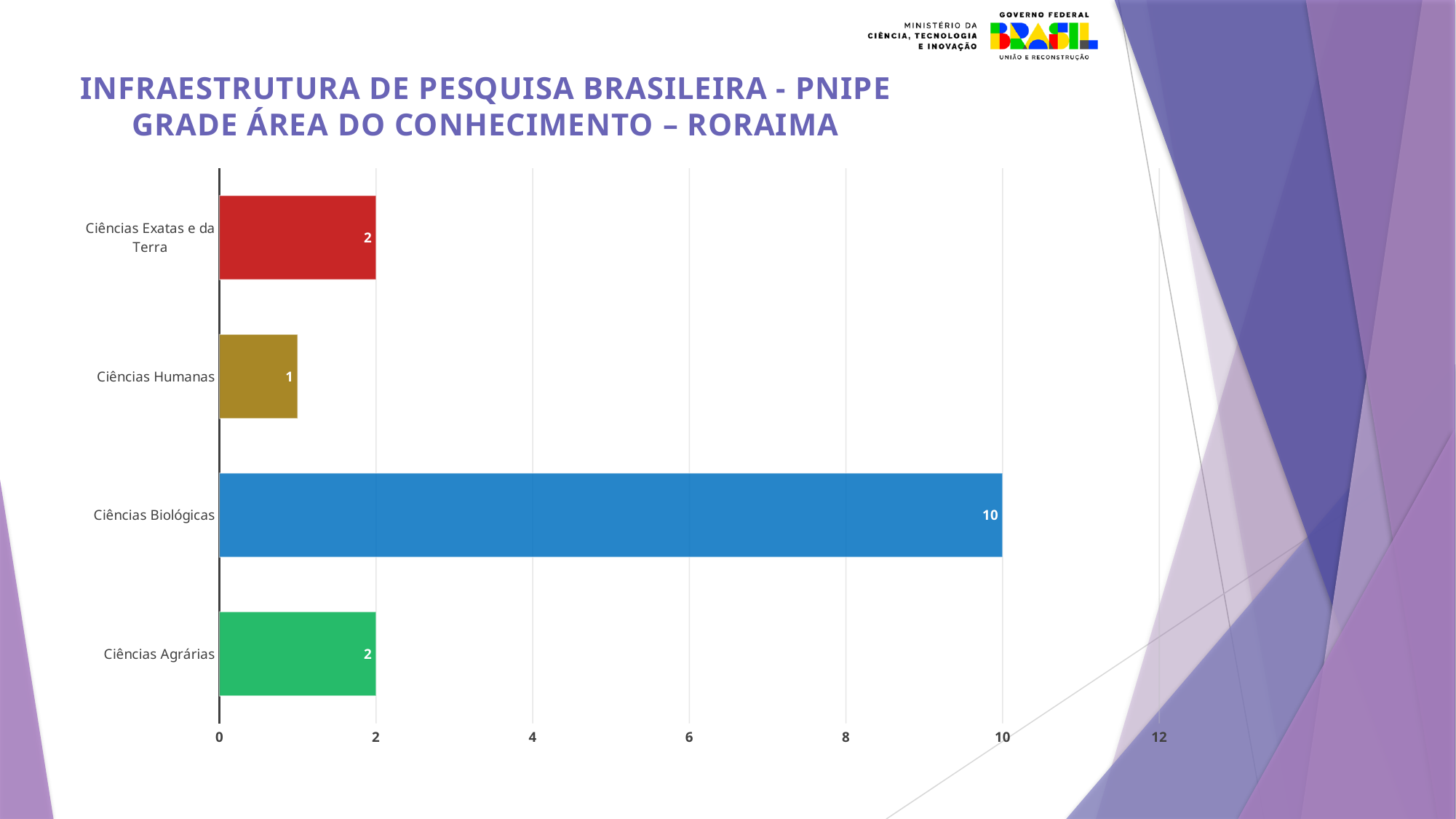
Is the value for Ciências Biológicas greater or less than 8? greater What is the value for Ciências Exatas e da Terra? 2 Which is larger, the value for Ciências Biológicas or the value for Ciências Exatas e da Terra? Ciências Biológicas What kind of chart is shown on the slide? bar chart What colour is the bar for Ciências Biológicas? blue What is the value for Ciências Agrárias? 2 What is the difference between the values for Ciências Biológicas and Ciências Humanas? 9 How many categories are shown in the chart? 4 What is the value for Ciências Biológicas? 10 Which category has the highest value? Ciências Biológicas What is the value for Ciências Humanas? 1 Which category has the lowest value? Ciências Humanas